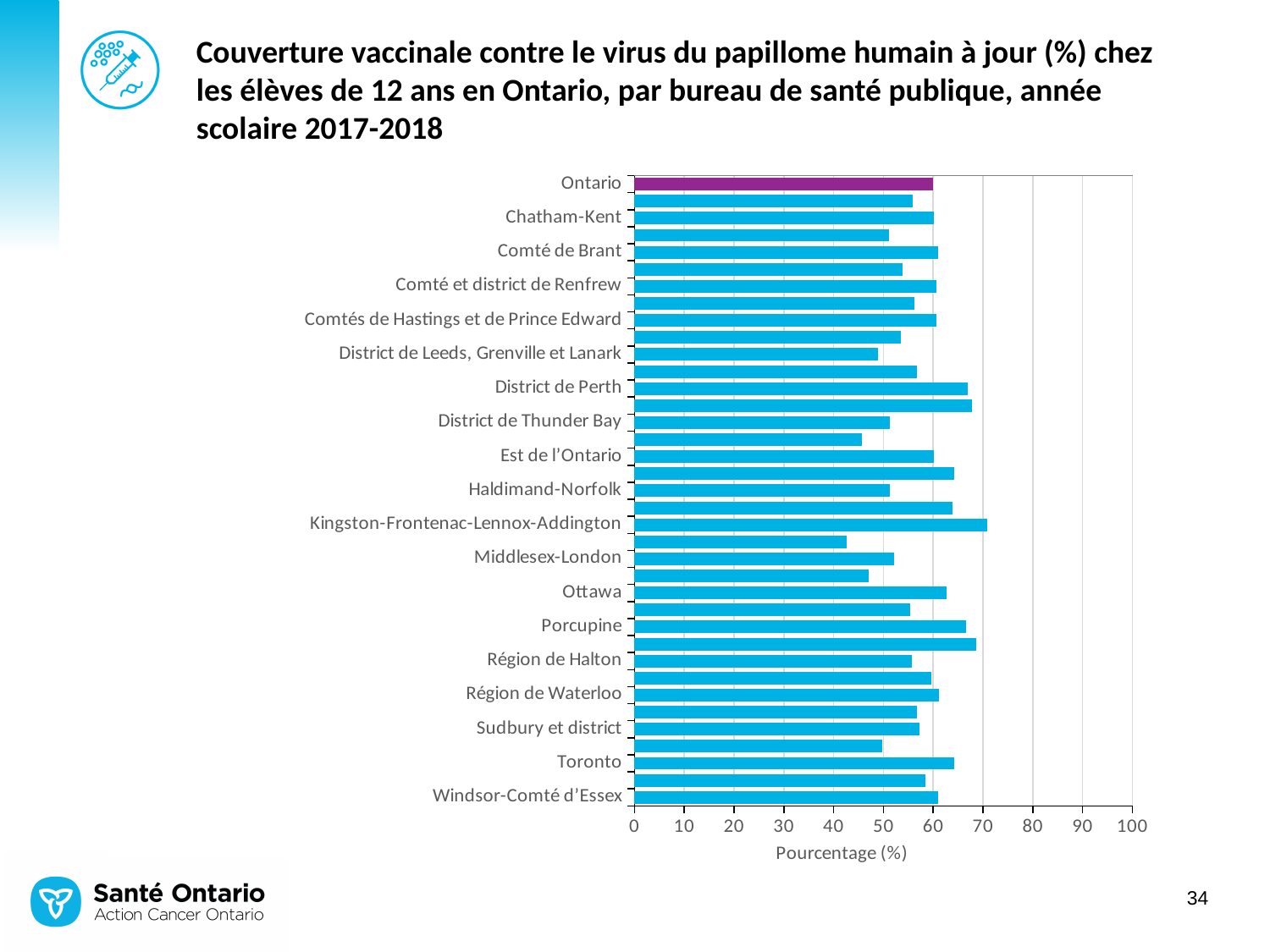
Is the value for Kingston-Frontenac-Lennox-Addington greater or less than 60? greater Which bar is shown in a different colour (purple) from the others? Ontario Is the value for District de Perth greater or less than 60? greater Is the value for District de Thunder Bay greater or less than 60? less Which has the higher value, District de Perth or Région de Halton? District de Perth What kind of chart is shown on the slide? bar chart Which has the higher value, Toronto or District de Thunder Bay? Toronto What is the title of the horizontal axis? Pourcentage (%) Which labelled public health unit has the highest vaccination coverage? Kingston-Frontenac-Lennox-Addington